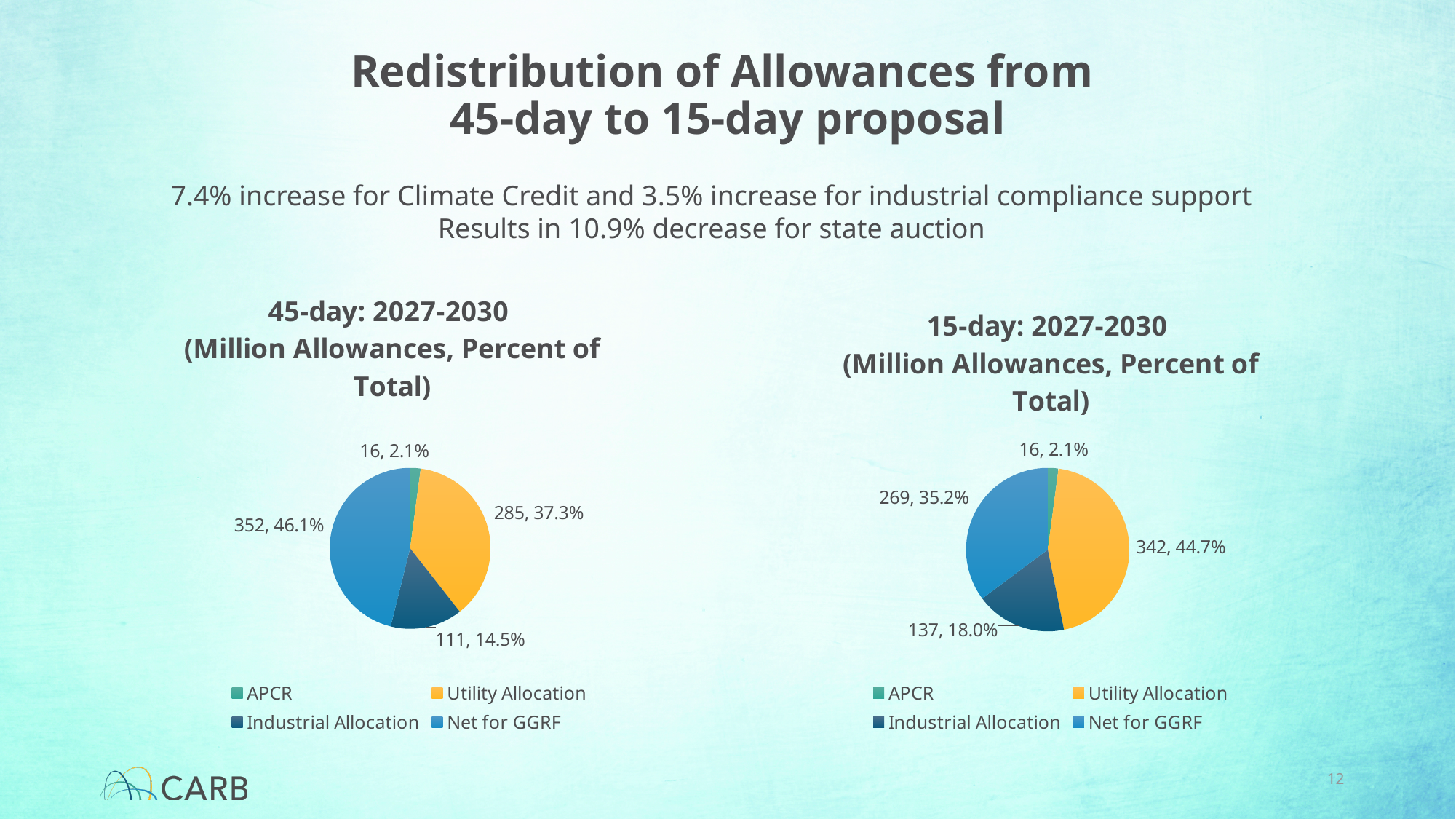
What is the difference in million allowances for Utility Allocation between the 15-day chart (342) and the 45-day chart (285)? 57 In the 15-day: 2027-2030 chart, which category has the smallest slice? APCR What type of chart is used on this slide? Pie chart In the 45-day: 2027-2030 chart, which category has the largest slice? Net for GGRF In the 45-day: 2027-2030 chart, what colour represents Net for GGRF? Blue In the 15-day: 2027-2030 chart, what percent of the total is Industrial Allocation? 18.0% How many categories does the legend of the 15-day: 2027-2030 chart list? 4 In the 15-day: 2027-2030 chart, which category has the largest slice? Utility Allocation In the 15-day: 2027-2030 chart, what is the data label for Net for GGRF? 269, 35.2% In the 45-day: 2027-2030 chart, what is the data label for Utility Allocation? 285, 37.3% In the 45-day: 2027-2030 chart, which is larger, Industrial Allocation or Utility Allocation? Utility Allocation In the 45-day: 2027-2030 chart, what percent of the total is Net for GGRF? 46.1%